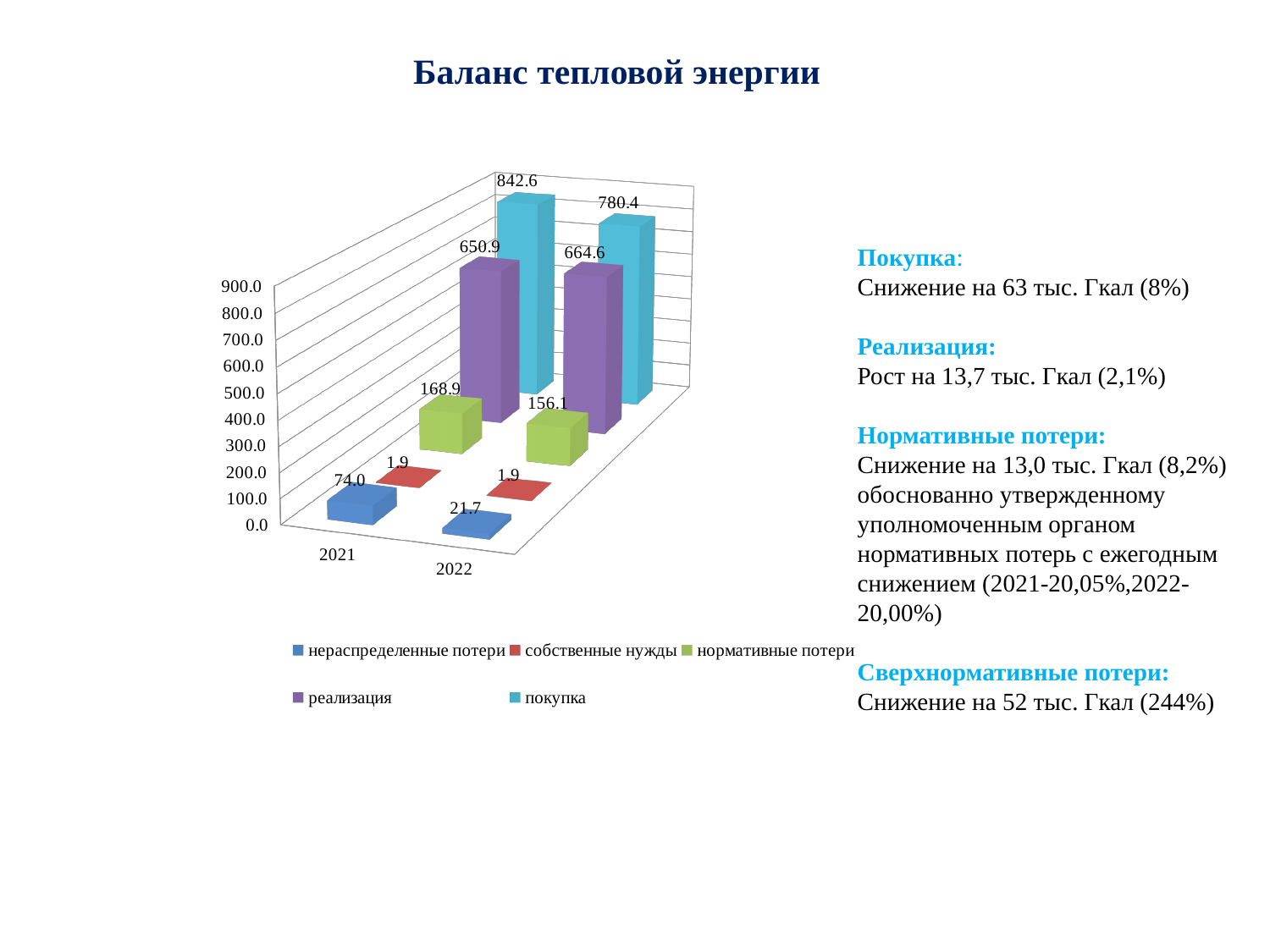
What kind of chart is shown on the slide? bar chart How many series does the legend list? 5 What is the difference between the покупка values for 2021 and 2022? 62.2 Which is larger, реализация in 2021 or реализация in 2022? реализация in 2022 Which series has the lowest value in 2021? собственные нужды How many categories are shown on the x axis? 2 What is the value for реализация in 2022? 664.6 What is the value for покупка in 2021? 842.6 What is the value for нераспределенные потери in 2022? 21.7 Which series has the highest value in 2022? покупка What is the value for нормативные потери in 2021? 168.9 What is the value for собственные нужды in 2022? 1.9